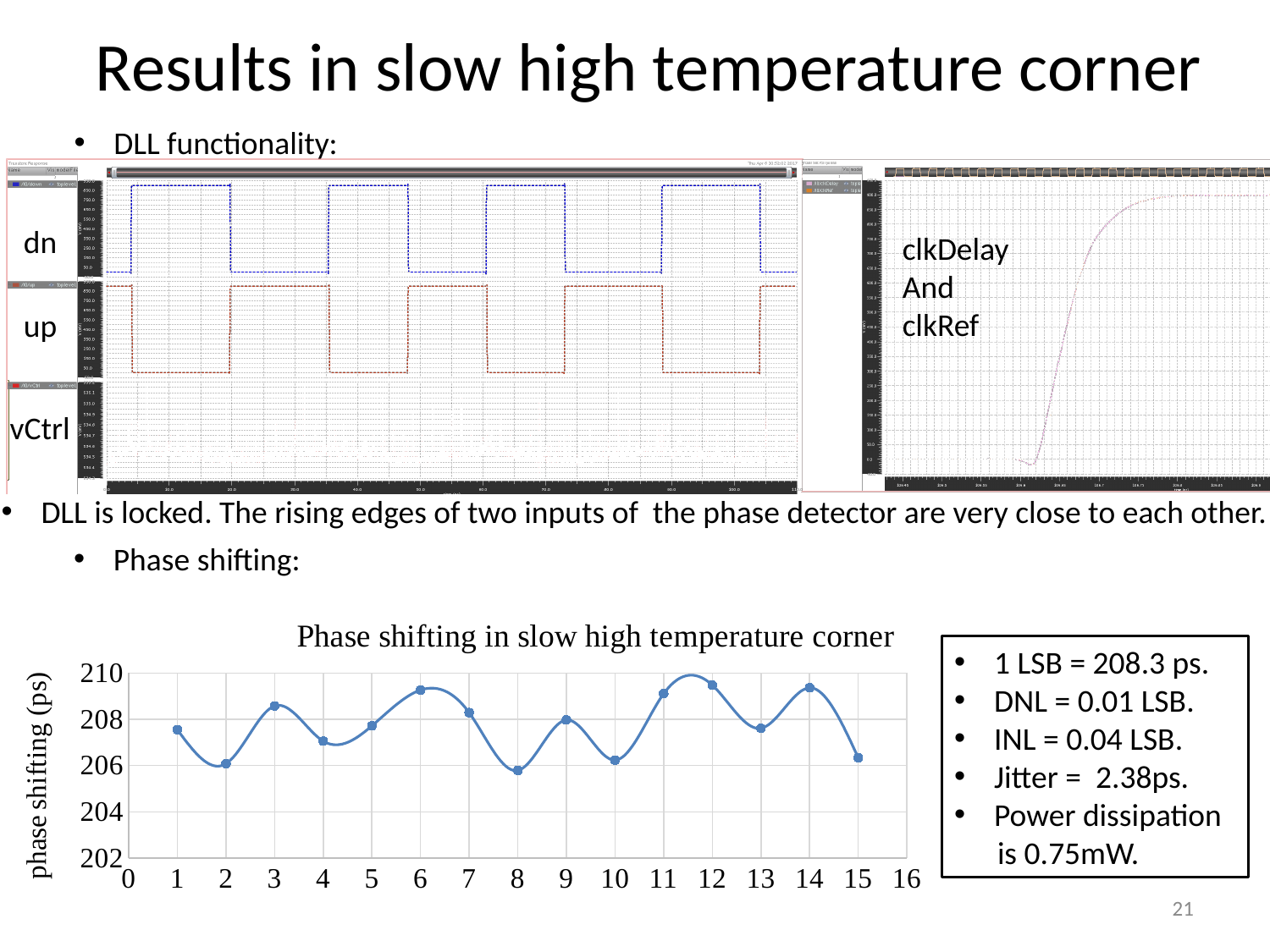
In the "Phase shifting in slow high temperature corner" chart, is the value at x = 1 greater or less than 206? greater What is the y-axis label of the "Phase shifting in slow high temperature corner" chart? phase shifting (ps) In the "Phase shifting in slow high temperature corner" chart, is the value at x = 12 greater or less than 208? greater What is the title of the line chart at the bottom of the slide? Phase shifting in slow high temperature corner How many data points are plotted in the "Phase shifting in slow high temperature corner" chart? 15 In the "Phase shifting in slow high temperature corner" chart, is the value at x = 10 greater or less than 208? less In the "Phase shifting in slow high temperature corner" chart, which has the larger value, x = 6 or x = 2? x = 6 What kind of chart is "Phase shifting in slow high temperature corner"? line chart In the "Phase shifting in slow high temperature corner" chart, which has the larger value, x = 8 or x = 11? x = 11 In the "Phase shifting in slow high temperature corner" chart, which has the larger value, x = 3 or x = 4? x = 3